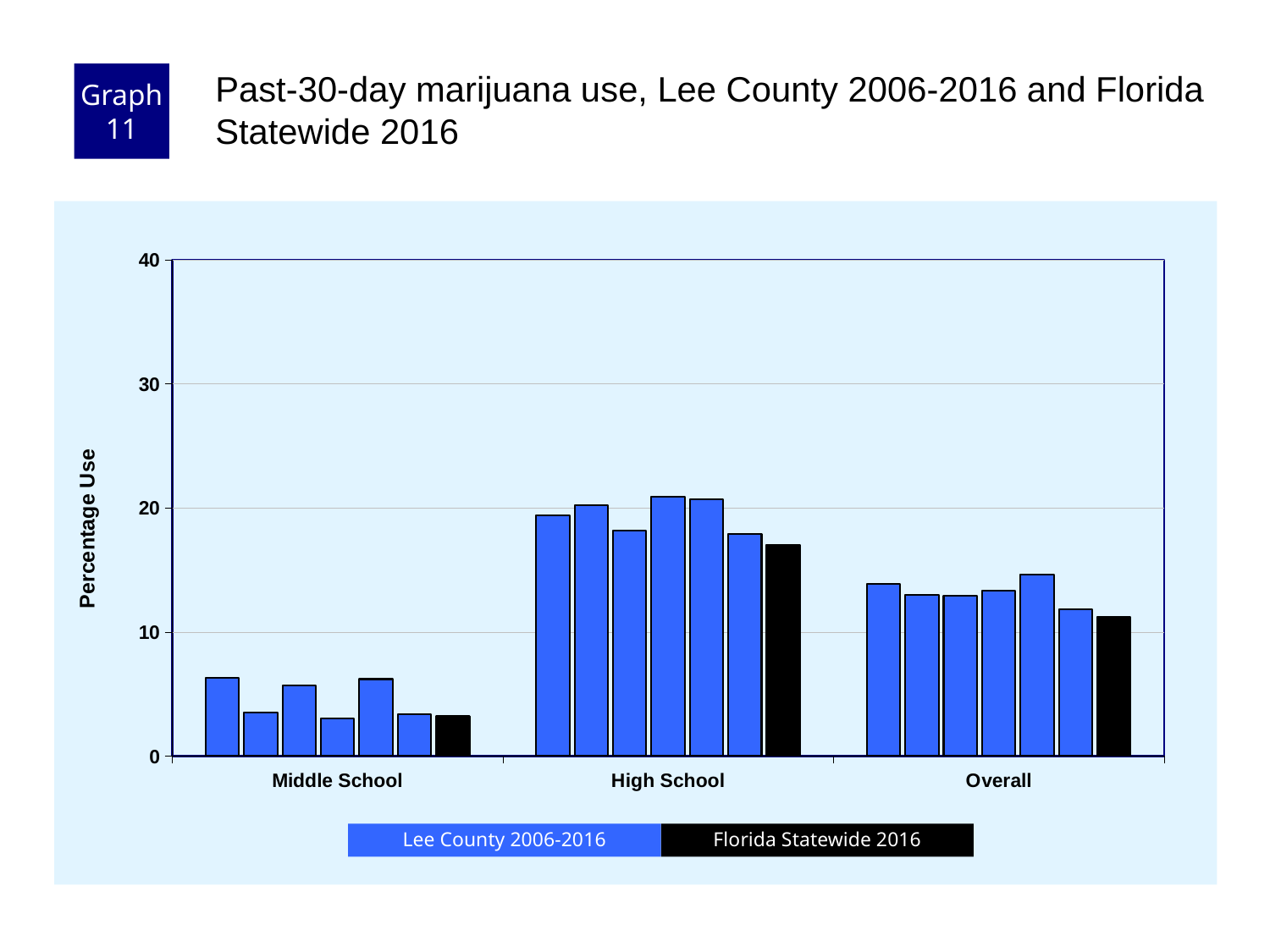
What is the label of the y axis? Percentage Use Which colour represents Florida Statewide 2016 in the legend? black Which is larger, the Florida Statewide 2016 value for High School or for Middle School? High School Is the Florida Statewide 2016 value for High School greater or less than 10? greater Is the Florida Statewide 2016 value for High School greater or less than 20? less Which category has the lowest percentage use values overall? Middle School How many school-level categories are shown on the x axis? 3 Which category has the highest percentage use values overall? High School Is the Florida Statewide 2016 value for Overall greater or less than 20? less What kind of chart is shown on the slide? bar chart How many series does the legend list? 2